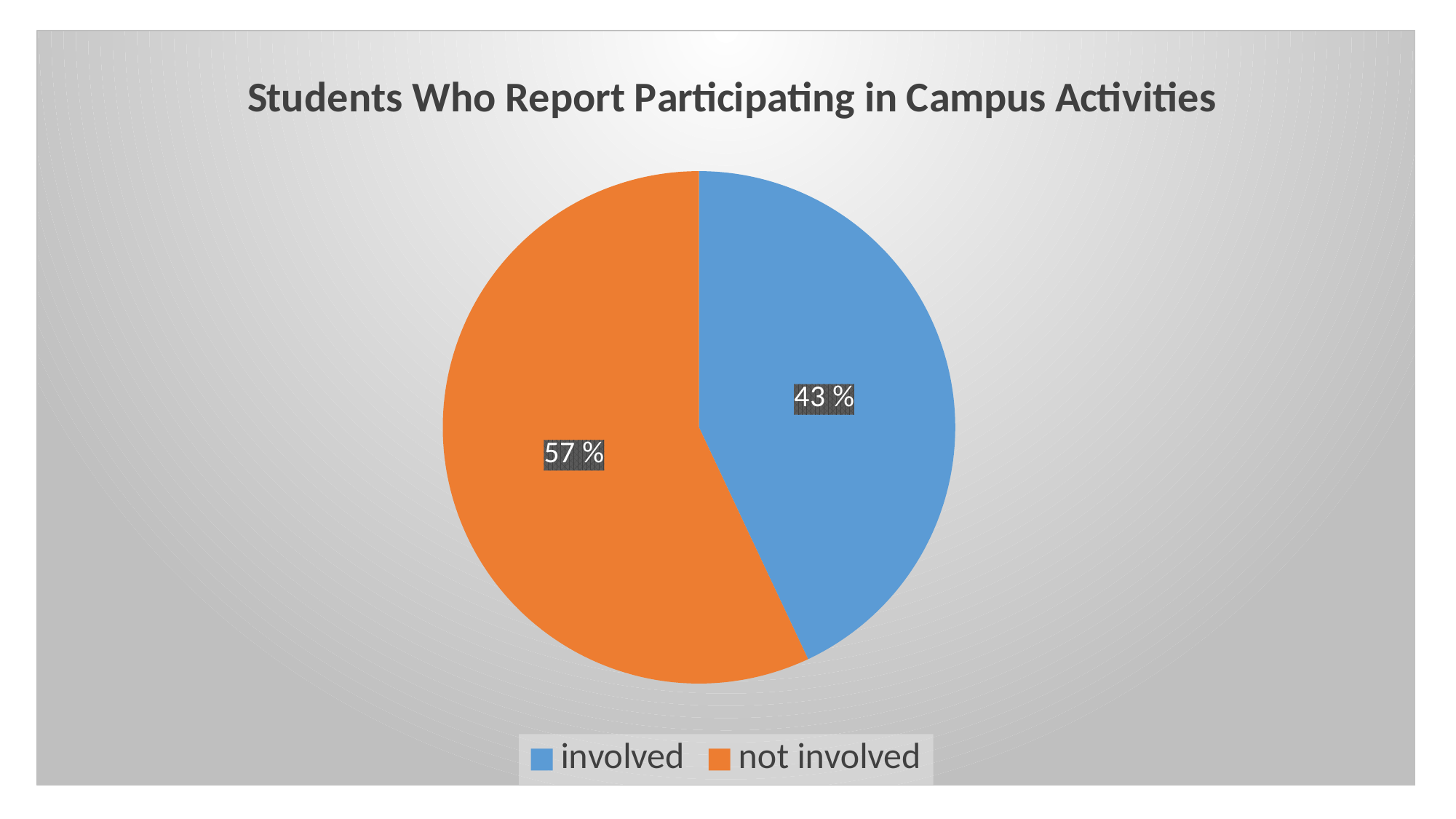
Which is larger, the involved slice or the not involved slice? not involved What is the title of the chart? Students Who Report Participating in Campus Activities What share of the pie does the involved slice represent? 43 % What colour is the not involved slice? orange What kind of chart is shown on the slide? pie chart Which slice of the pie is the smallest? involved What percentage of students are shown as involved? 43 % How many slices does the pie chart have? 2 What percentage of students are shown as not involved? 57 % Which slice of the pie is the largest? not involved How many entries does the legend list? 2 What is the difference in percentage points between the not involved and involved slices? 14